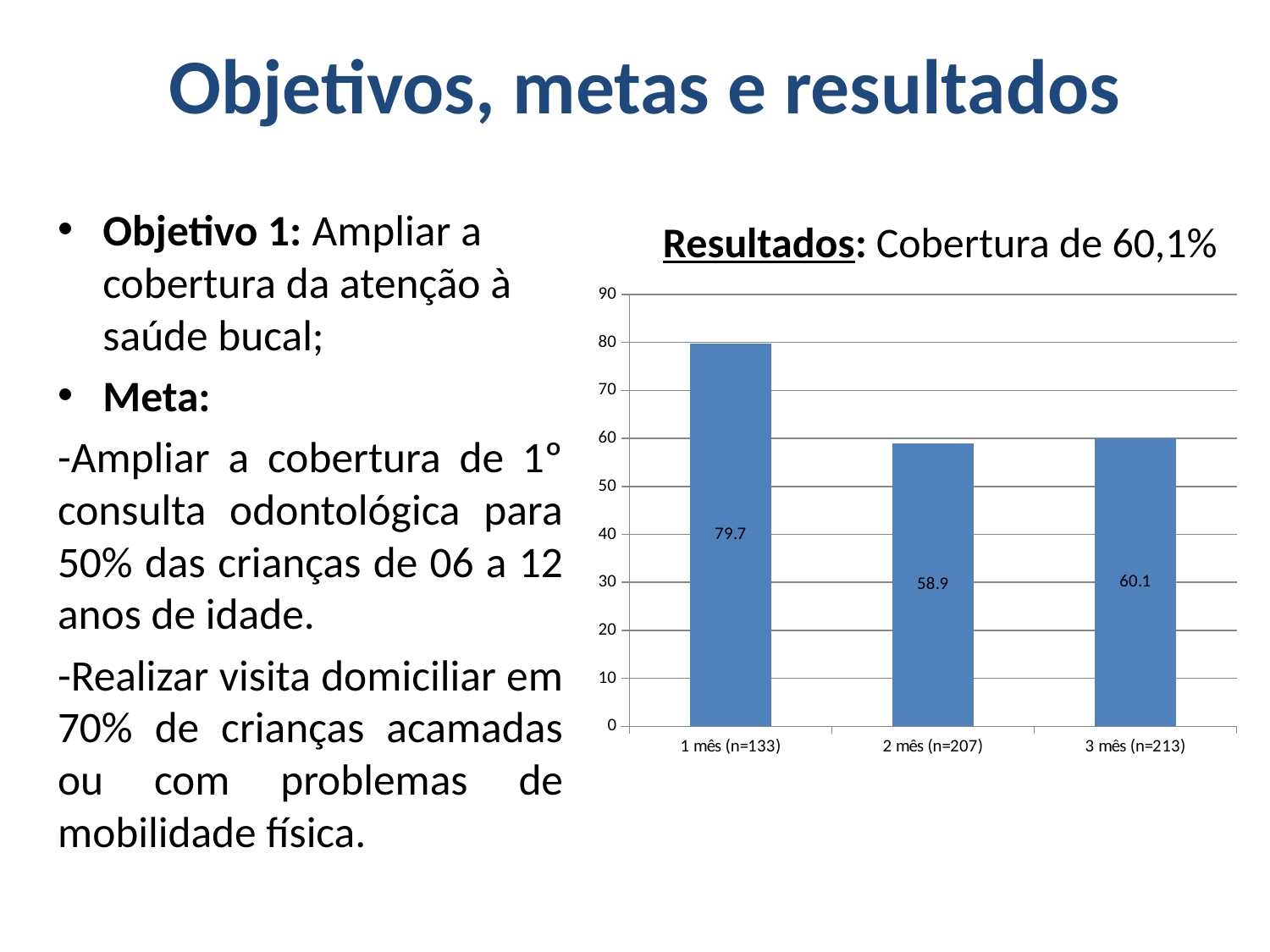
How many categories are shown on the x axis? 3 What is the difference between the values for 1 mês (n=133) and 3 mês (n=213)? 19.6 What is the value for 2 mês (n=207)? 58.9 Which is larger, the value for 1 mês (n=133) or the value for 2 mês (n=207)? 1 mês (n=133) What is the value for 1 mês (n=133)? 79.7 Is the value for 2 mês (n=207) greater or less than 60? less What kind of chart is shown on the slide? bar chart Which category has the highest value? 1 mês (n=133) Which category has the lowest value? 2 mês (n=207) What is the value for 3 mês (n=213)? 60.1 What is the difference between the values for 3 mês (n=213) and 2 mês (n=207)? 1.2 What is the title shown above the chart? Resultados: Cobertura de 60,1%